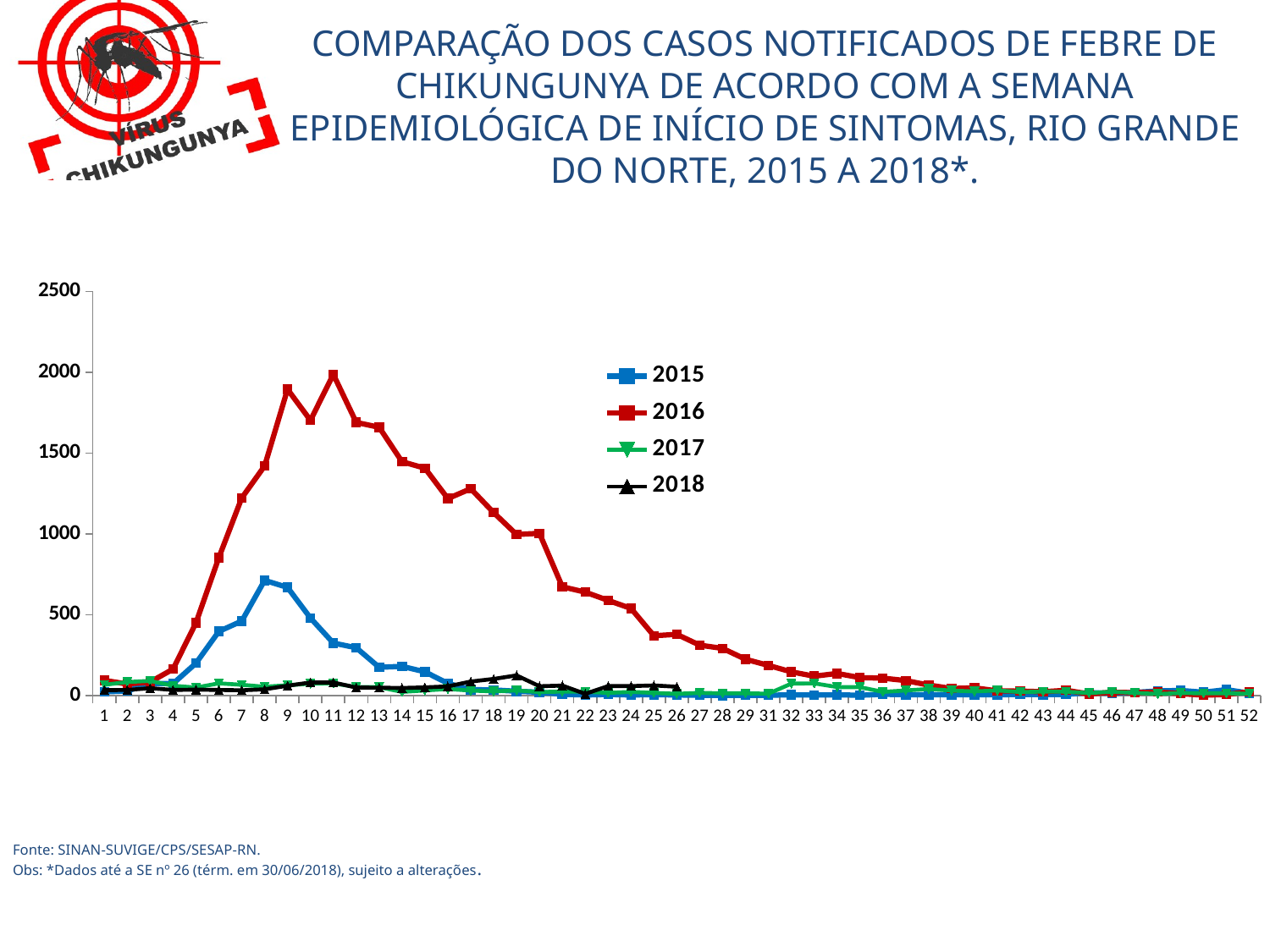
In which week does the 2016 series reach its peak? 11 What colour is used for the 2016 series in the legend? red Is the value for 2015 at week 8 greater or less than 500? greater How many series does the legend list? 4 Is the value for 2016 at week 6 greater or less than 500? greater In which week does the 2015 series reach its peak? 8 Is the value for 2016 at week 11 greater or less than 1500? greater At week 11, which series has the larger value, 2015 or 2016? 2016 What kind of chart is shown on the slide? line chart Which year's series reaches the highest value on the chart? 2016